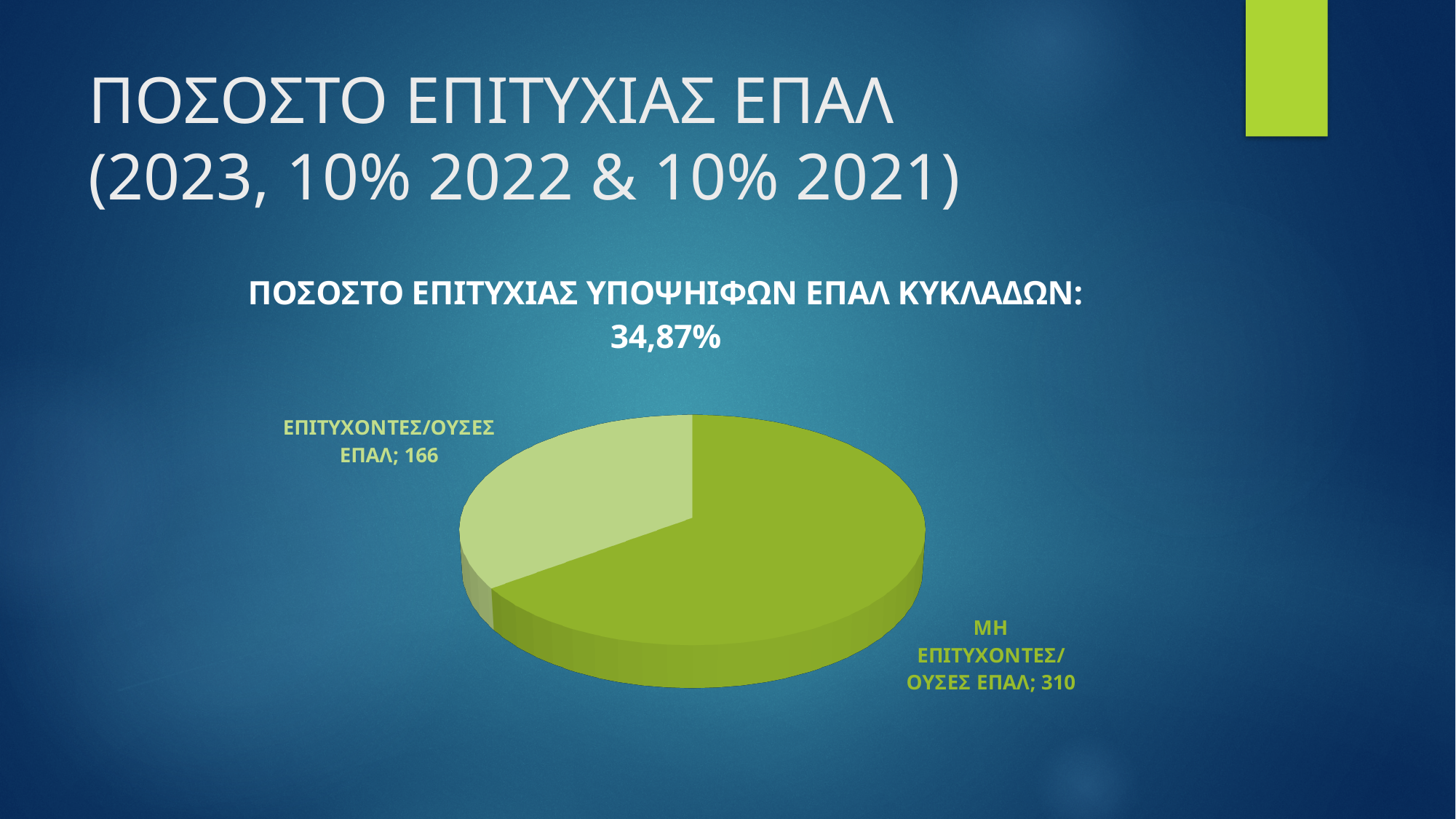
Which slice of the pie chart is the largest? ΜΗ ΕΠΙΤΥΧΟΝΤΕΣ/ΟΥΣΕΣ ΕΠΑΛ What success percentage is stated in the chart title? 34,87% Which slice of the pie chart is the smallest? ΕΠΙΤΥΧΟΝΤΕΣ/ΟΥΣΕΣ ΕΠΑΛ What share of the pie does the ΕΠΙΤΥΧΟΝΤΕΣ/ΟΥΣΕΣ ΕΠΑΛ slice represent? 34,87% How many slices does the pie chart have? 2 Which is larger: ΕΠΙΤΥΧΟΝΤΕΣ/ΟΥΣΕΣ ΕΠΑΛ or ΜΗ ΕΠΙΤΥΧΟΝΤΕΣ/ΟΥΣΕΣ ΕΠΑΛ? ΜΗ ΕΠΙΤΥΧΟΝΤΕΣ/ΟΥΣΕΣ ΕΠΑΛ What is the difference between the ΜΗ ΕΠΙΤΥΧΟΝΤΕΣ/ΟΥΣΕΣ ΕΠΑΛ value and the ΕΠΙΤΥΧΟΝΤΕΣ/ΟΥΣΕΣ ΕΠΑΛ value? 144 What type of chart is shown on the slide? pie chart What is the title of the pie chart? ΠΟΣΟΣΤΟ ΕΠΙΤΥΧΙΑΣ ΥΠΟΨΗΙΦΩΝ ΕΠΑΛ ΚΥΚΛΑΔΩΝ: 34,87% What is the total of the two slices in the pie chart? 476 What is the value for ΜΗ ΕΠΙΤΥΧΟΝΤΕΣ/ΟΥΣΕΣ ΕΠΑΛ in the pie chart? 310 What is the value for ΕΠΙΤΥΧΟΝΤΕΣ/ΟΥΣΕΣ ΕΠΑΛ in the pie chart? 166